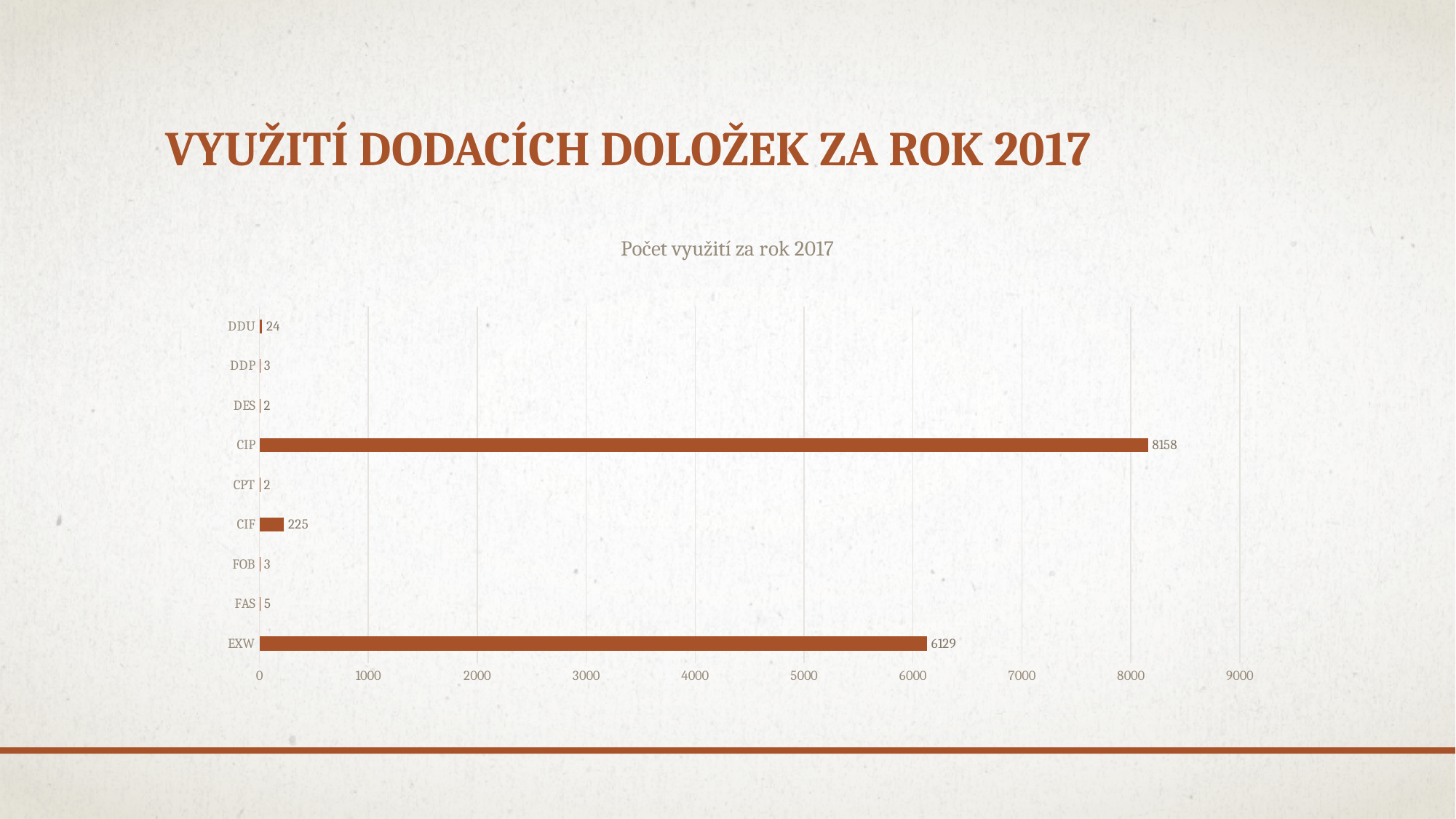
What is the difference between the values for FAS and FOB? 2 What is the value for CIP? 8158 What is the title of the chart? Počet využití za rok 2017 Which category has the highest value? CIP What is the value for EXW? 6129 Is the value for EXW greater or less than 6000? greater What kind of chart is shown on the slide? Bar chart What is the difference between the values for CIP and EXW? 2029 How many categories are shown in the chart? 9 Which is larger, the value for CIF or the value for DDU? CIF What is the value for CIF? 225 What is the value for DDU? 24